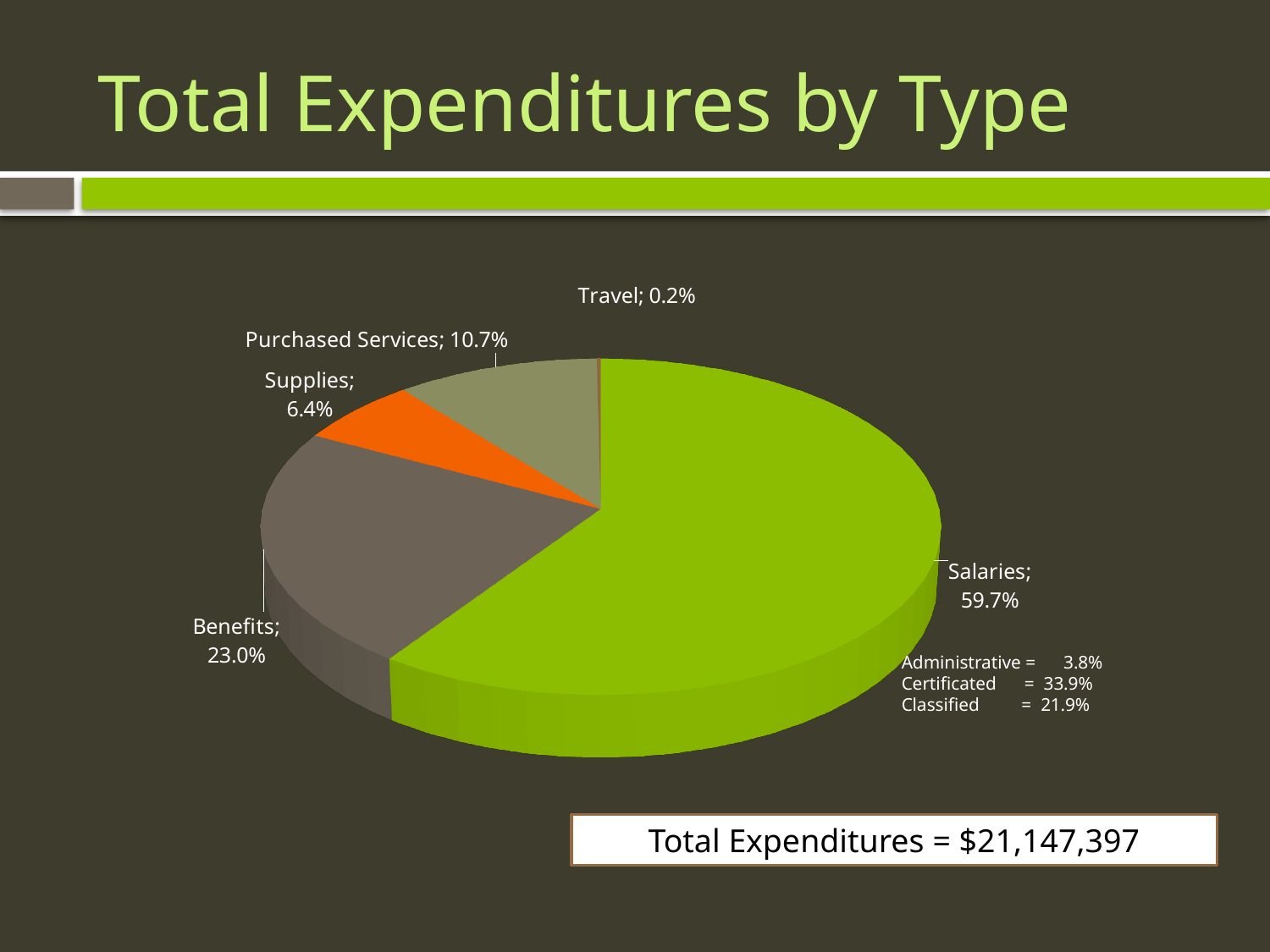
Which expenditure type has the smallest share of the pie? Travel How many expenditure types are shown as slices in the pie chart? 5 What share of total expenditures is Salaries? 59.7% How many percentage points larger is the Salaries share than the Benefits share? 36.7 What share of total expenditures is Supplies? 6.4% Which expenditure type has the largest share of the pie? Salaries What is the title of the chart on the slide? Total Expenditures by Type What share of total expenditures is Benefits? 23.0% Which is larger, the share for Purchased Services or the share for Supplies? Purchased Services What share of total expenditures is Purchased Services? 10.7% What kind of chart is shown on the slide? Pie chart What share of total expenditures is Travel? 0.2%